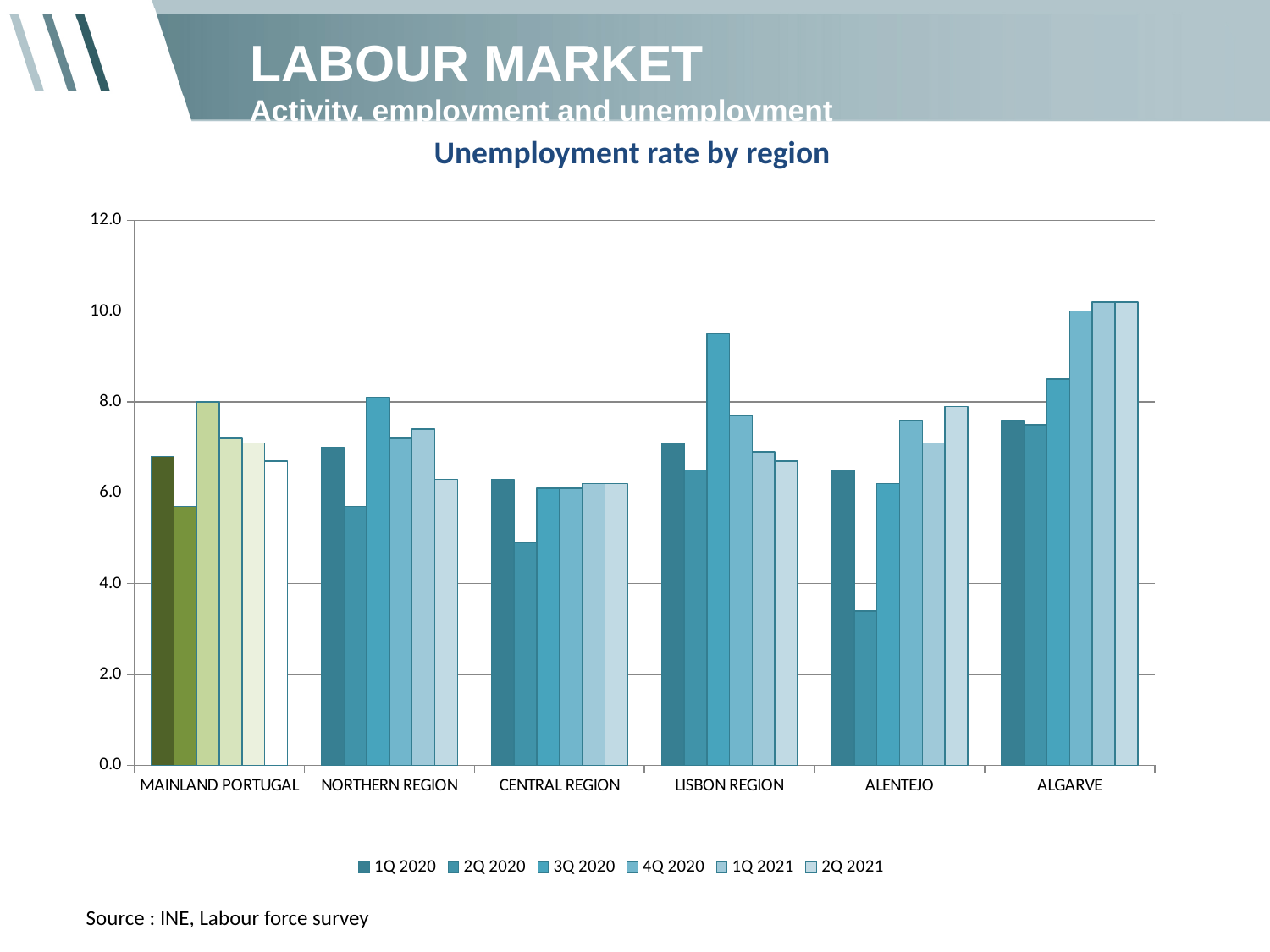
Which region has the tallest bar in the chart? ALGARVE Which series is listed last in the legend? 2Q 2021 Is the value for 3Q 2020 in the LISBON REGION greater or less than 8.0? greater What kind of chart is shown on the slide? bar chart How many series does the legend list? 6 Is the value for 2Q 2020 in the CENTRAL REGION greater or less than 6.0? less What is the title of the chart? Unemployment rate by region Is the value for 2Q 2021 in ALGARVE greater or less than 10.0? greater Which is larger, the 3Q 2020 value for the NORTHERN REGION or the 3Q 2020 value for the CENTRAL REGION? NORTHERN REGION Which region has the shortest bar in the chart? ALENTEJO How many regions are shown on the x axis of the chart? 6